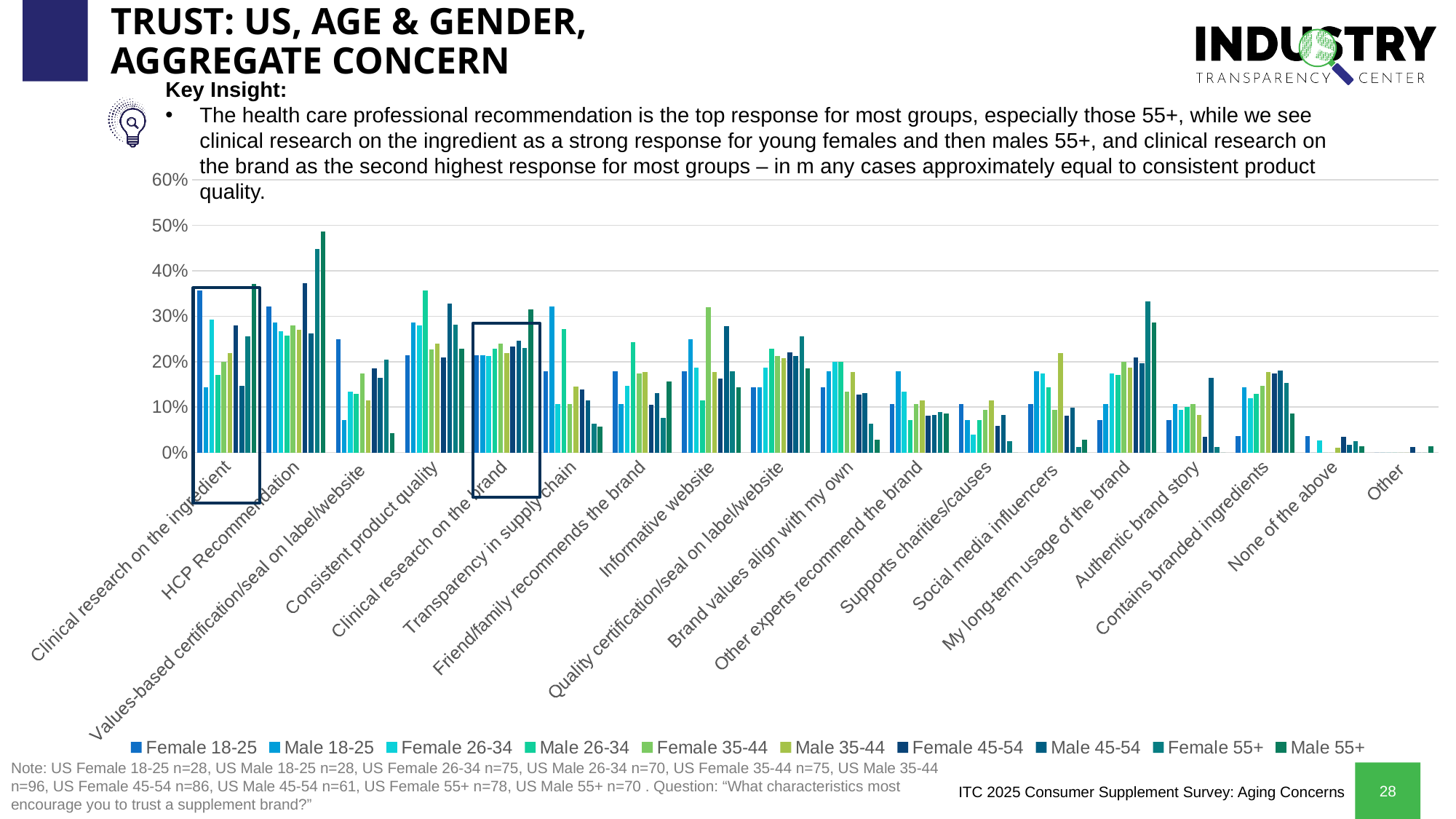
Is the value for Female 55+ in the My long-term usage of the brand category greater or less than 20%? greater Within the HCP Recommendation category, which series has the highest value? Male 55+ What is the highest value shown on the chart's vertical axis? 60% Which category contains the tallest bar in the chart? HCP Recommendation Is the value for Female 18-25 in the Clinical research on the ingredient category greater or less than 30%? greater How many series does the chart legend list? 10 Is the value for Male 55+ in the HCP Recommendation category greater or less than 40%? greater How many categories are shown along the x axis of the chart? 18 Which category has the lowest values overall in the chart? Other In the Clinical research on the ingredient category, which is larger: the value for Female 18-25 or the value for Male 18-25? Female 18-25 What kind of chart is shown on the slide? bar chart